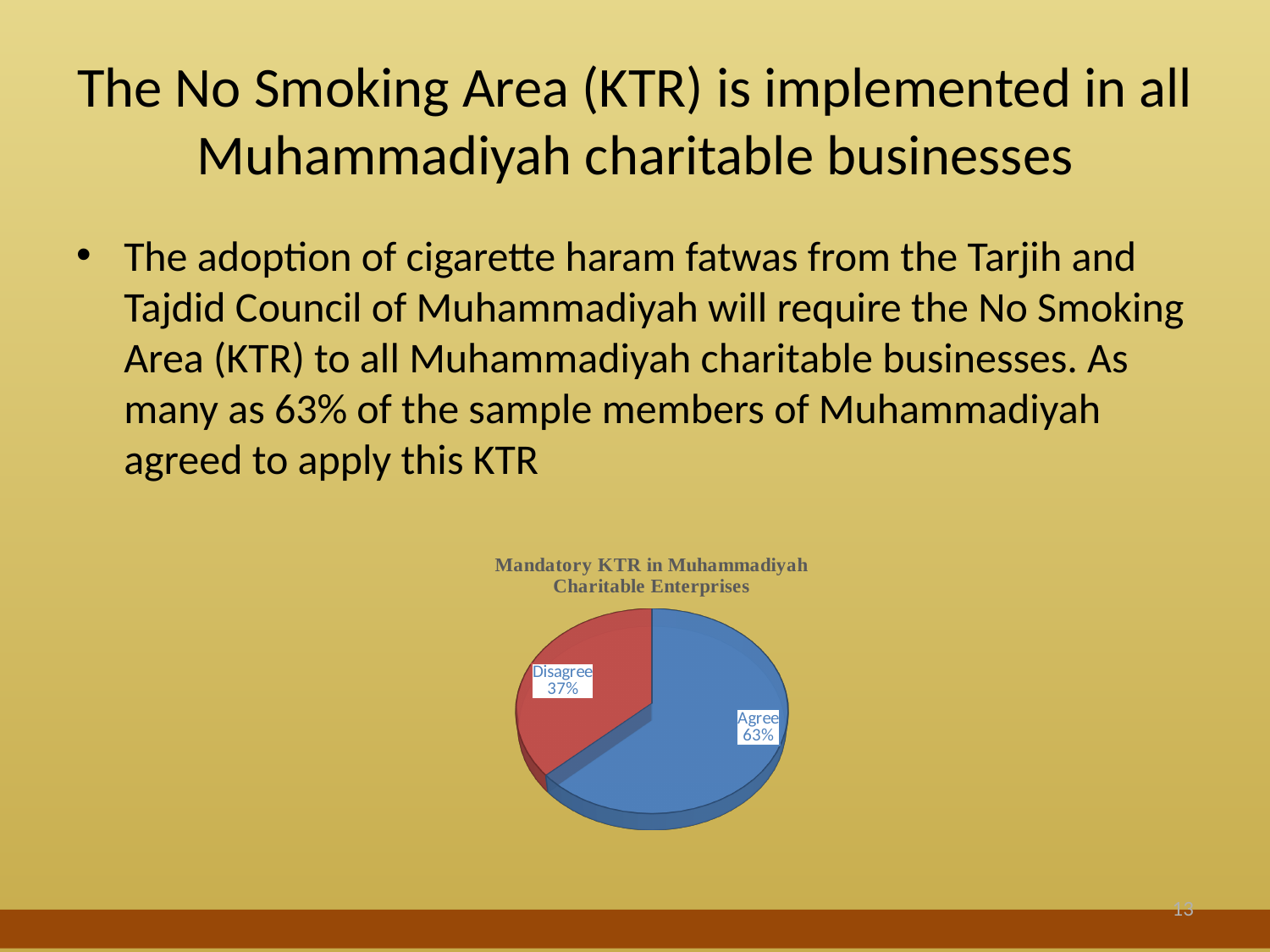
What percentage of the pie is labelled Agree? 63% Which slice of the pie is the smallest? Disagree What kind of chart is shown on the slide? pie chart Which slice of the pie is the largest? Agree What share of the pie does the Disagree slice represent? 37% What percentage of the pie is labelled Disagree? 37% What is the title of the chart? Mandatory KTR in Muhammadiyah Charitable Enterprises Which is larger, the Agree slice or the Disagree slice? Agree What is the difference in percentage points between the Agree and Disagree slices? 26 What colour is the Agree slice of the pie? blue How many slices does the pie chart have? 2